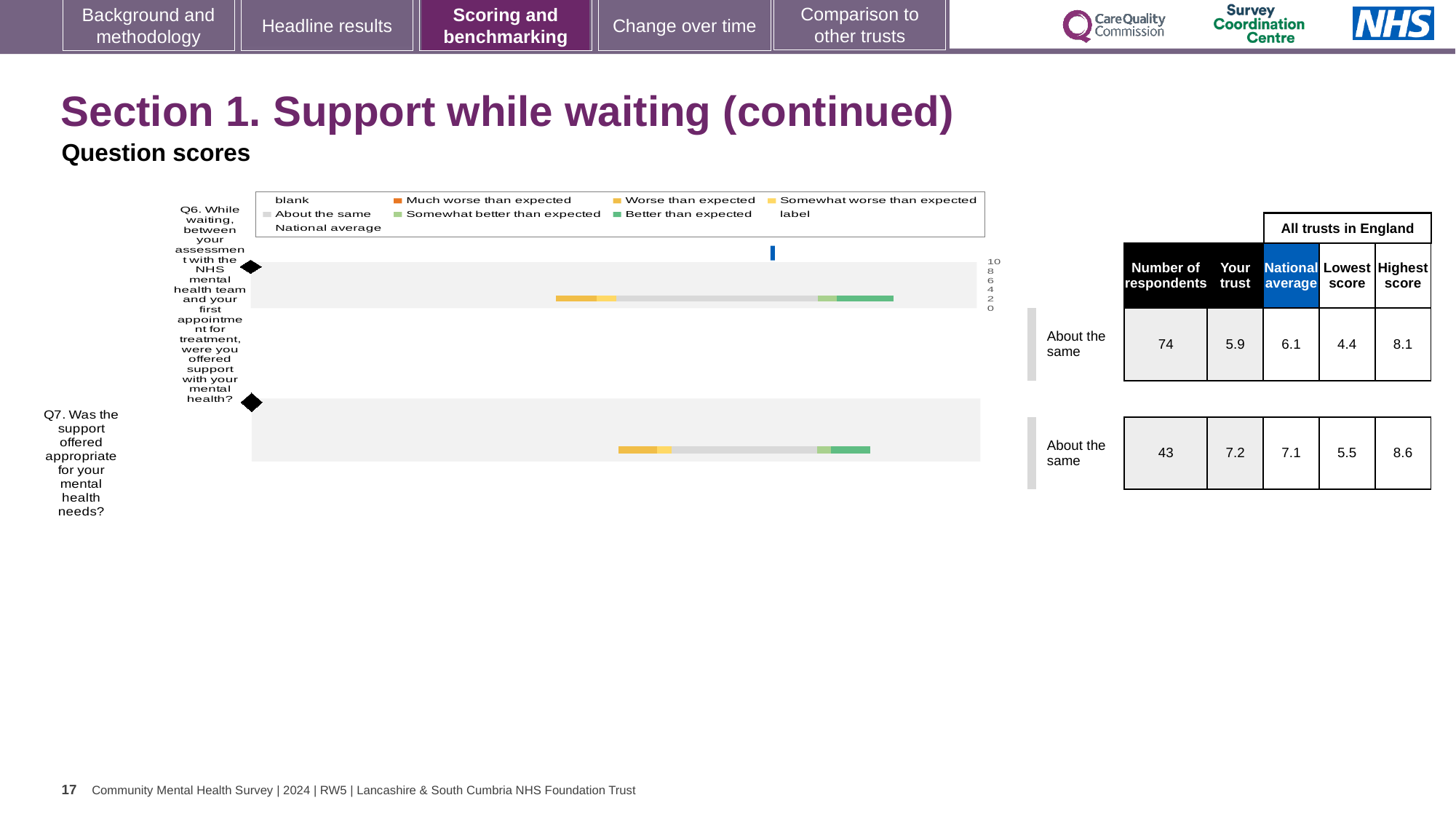
What is the national average score for Q7? 7.1 What is the 'Your trust' score for Q6? 5.9 How many questions (categories) are plotted in the chart? 2 Which is larger for Q6: the 'Your trust' score or the national average? National average What is the highest score among all trusts in England for Q7? 8.6 Which question has the lower 'Your trust' score, Q6 or Q7? Q6 How many respondents answered Q6? 74 What kind of chart is shown on the slide? bar chart What is the difference between the highest and lowest scores for Q6? 3.7 What is the difference between the 'Your trust' score and the national average for Q7? 0.1 What benchmark category is shown for both Q6 and Q7? About the same How many entries does the chart legend list? 9